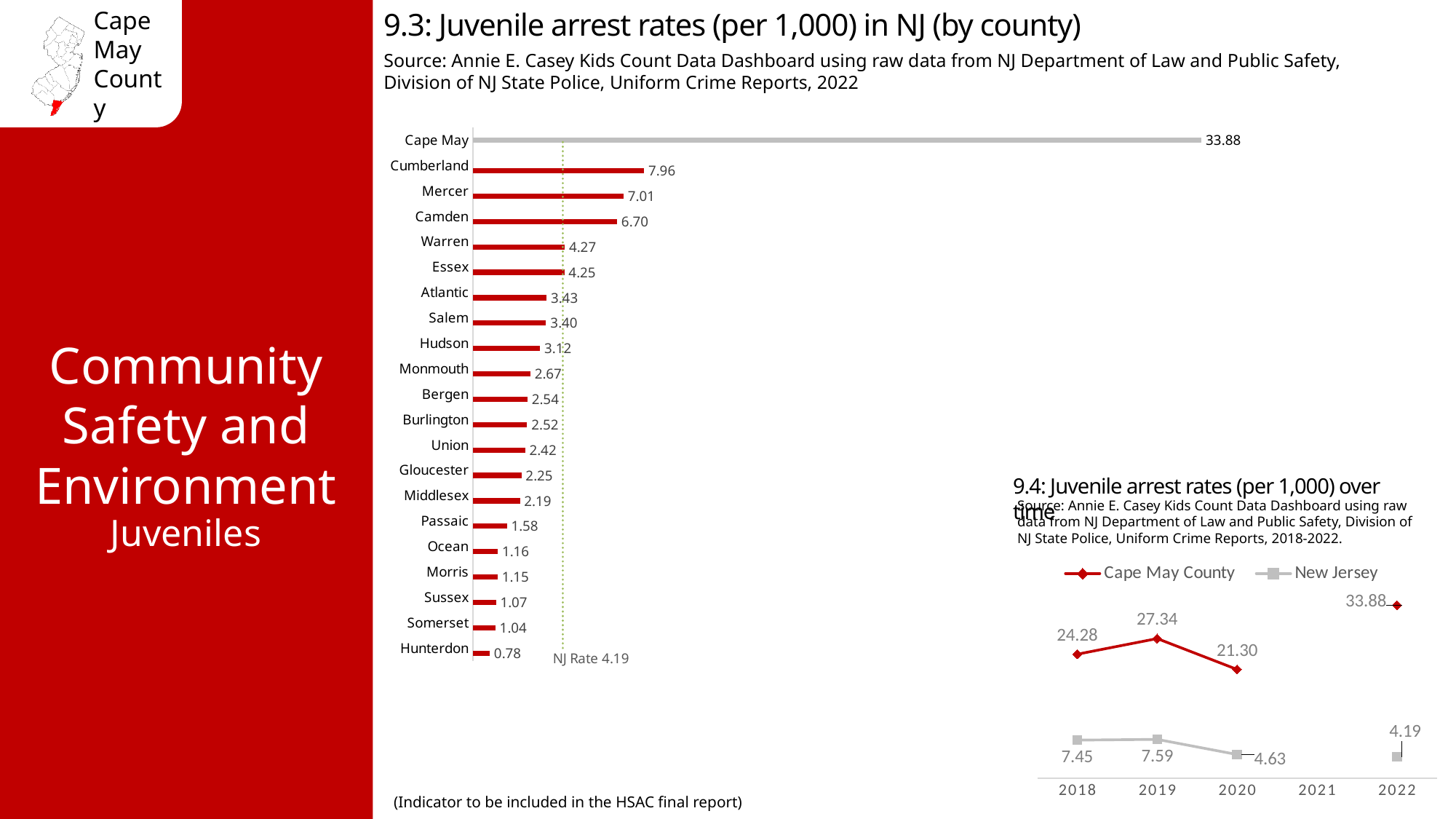
In the chart '9.3: Juvenile arrest rates (per 1,000) in NJ (by county)', how many counties are shown? 21 In the chart '9.3: Juvenile arrest rates (per 1,000) in NJ (by county)', what is the value for Cumberland? 7.96 In the chart '9.3: Juvenile arrest rates (per 1,000) in NJ (by county)', what is the difference between the rates for Mercer and Camden? 0.31 In the chart '9.4: Juvenile arrest rates (per 1,000) over time', how many series does the legend list? 2 What kind of chart is '9.3: Juvenile arrest rates (per 1,000) in NJ (by county)'? bar chart In the chart '9.4: Juvenile arrest rates (per 1,000) over time', what was the New Jersey rate in 2020? 4.63 In the chart '9.3: Juvenile arrest rates (per 1,000) in NJ (by county)', what is the juvenile arrest rate for Cape May? 33.88 In the chart '9.3: Juvenile arrest rates (per 1,000) in NJ (by county)', what NJ rate is marked by the dotted reference line? 4.19 In the chart '9.3: Juvenile arrest rates (per 1,000) in NJ (by county)', which county has the highest juvenile arrest rate? Cape May In the chart '9.4: Juvenile arrest rates (per 1,000) over time', what is the difference between the Cape May County and New Jersey rates in 2022? 29.69 In the chart '9.3: Juvenile arrest rates (per 1,000) in NJ (by county)', which county has the lowest juvenile arrest rate? Hunterdon In the chart '9.4: Juvenile arrest rates (per 1,000) over time', what was the Cape May County rate in 2019? 27.34